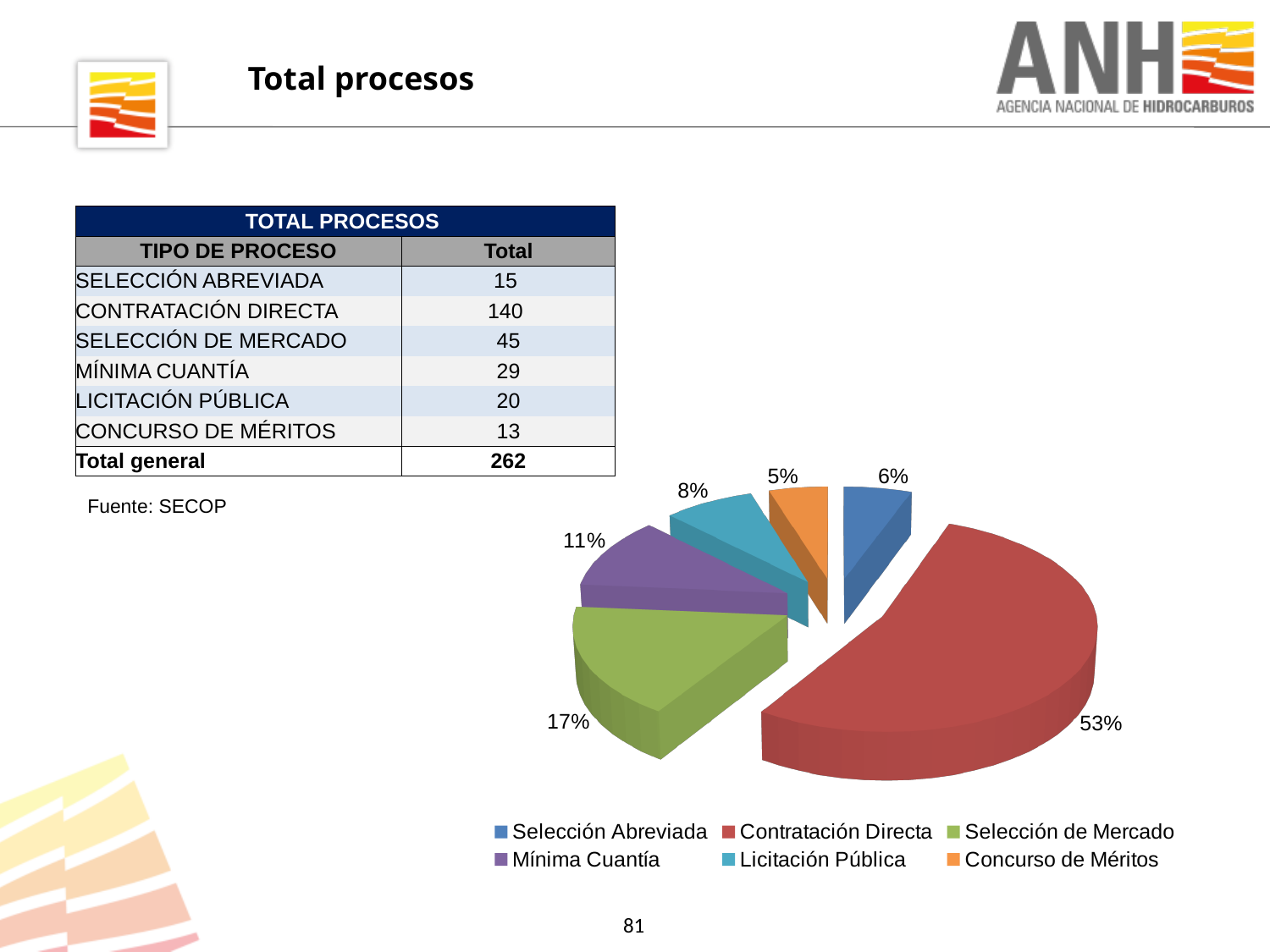
What share of the pie does Mínima Cuantía represent? 11% Which category has the smallest slice of the pie? Concurso de Méritos What kind of chart is shown on the slide? pie chart What colour is the slice for Contratación Directa? red What share of the pie does Contratación Directa represent? 53% What share of the pie does Concurso de Méritos represent? 5% How many categories does the legend of the pie chart list? 6 Which category has the largest slice of the pie? Contratación Directa Which slice is larger, Selección de Mercado or Mínima Cuantía? Selección de Mercado